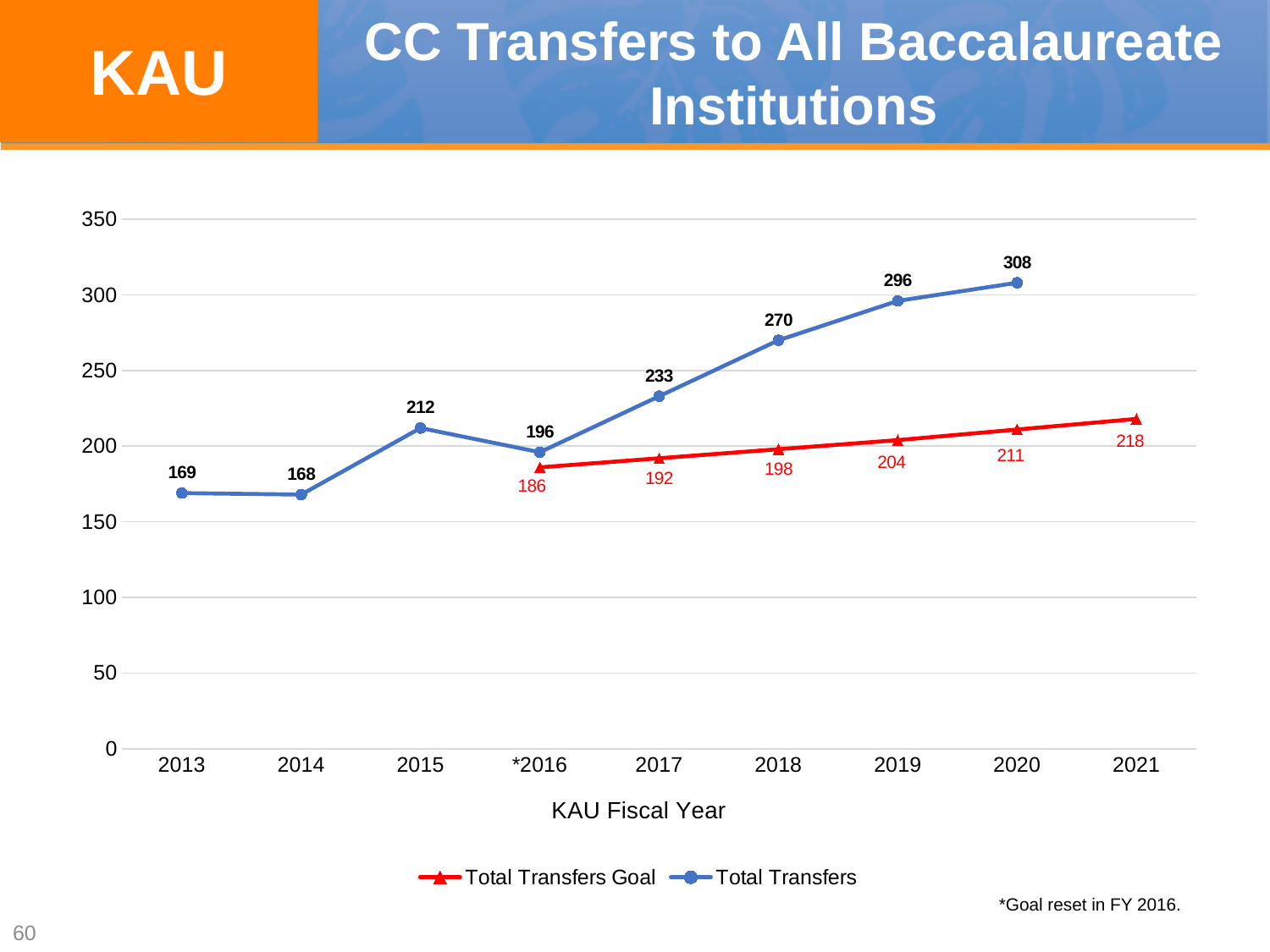
How many series does the legend list? 2 Which year has the lowest Total Transfers value? 2014 How many years are shown on the x axis? 9 What is the Total Transfers value for 2020? 308 Does the Total Transfers Goal series rise or fall from *2016 to 2021? Rise What is the Total Transfers value for 2014? 168 What is the x-axis title of the chart? KAU Fiscal Year What is the Total Transfers Goal value for 2019? 204 What kind of chart is shown? Line chart Which is larger in *2016: Total Transfers or Total Transfers Goal? Total Transfers Which year has the highest Total Transfers value? 2020 What is the difference between Total Transfers and Total Transfers Goal in 2018? 72